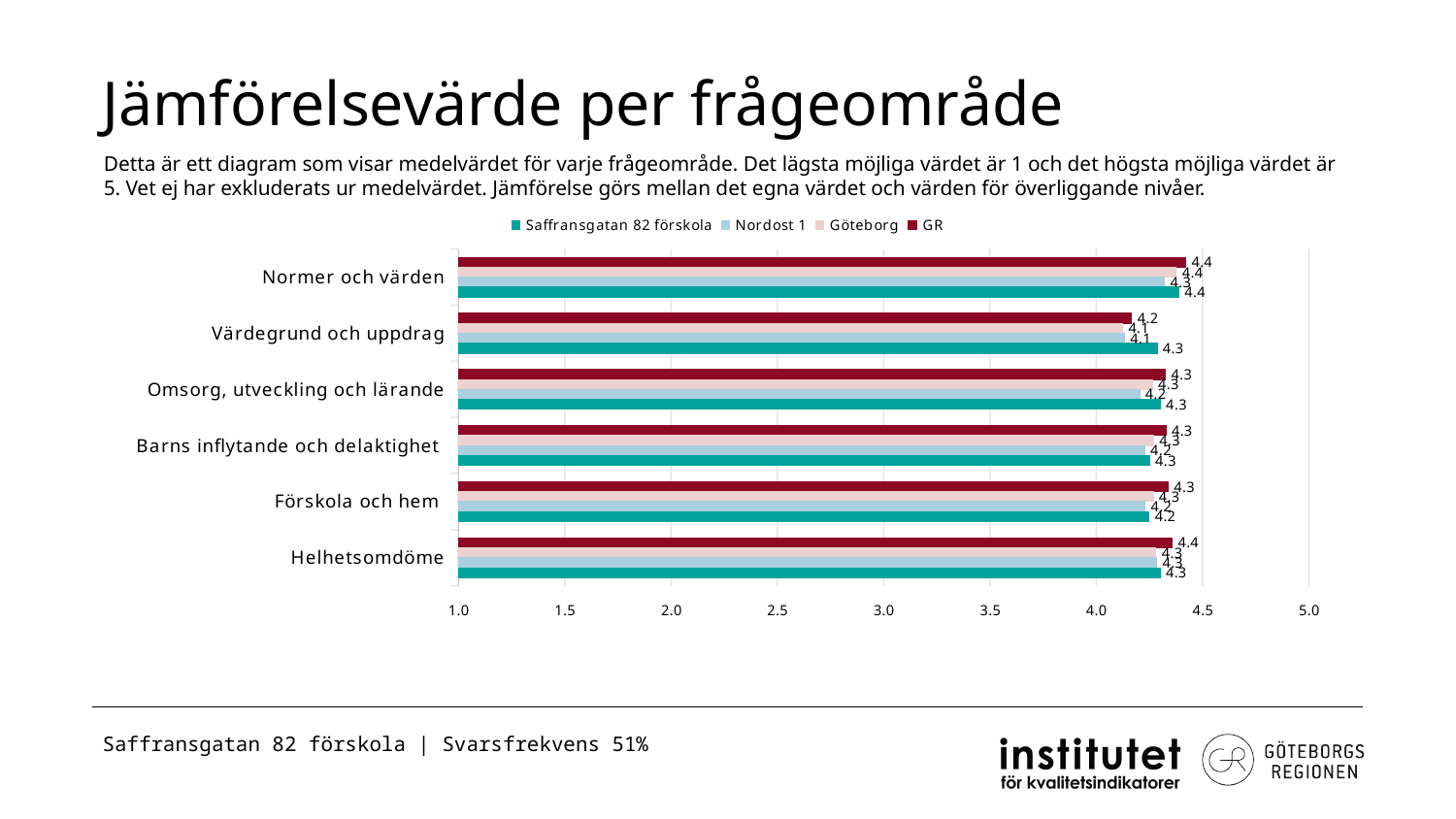
In which question area does Saffransgatan 82 förskola have its highest value? Normer och värden How many series does the legend list? 4 Which colour represents GR in the legend? dark red What is the value for GR in 'Helhetsomdöme'? 4,4 What is the value for Nordost 1 in 'Normer och värden'? 4,3 What is the difference between the Saffransgatan 82 förskola value and the GR value in 'Värdegrund och uppdrag'? 0,1 What is the value for Göteborg in 'Förskola och hem'? 4,3 In which question area does Saffransgatan 82 förskola have its lowest value? Förskola och hem What is the value for Saffransgatan 82 förskola in 'Värdegrund och uppdrag'? 4,3 How many question areas (categories) are shown on the y axis? 6 What type of chart is shown on the slide? bar chart In 'Värdegrund och uppdrag', which is larger: the value for Saffransgatan 82 förskola or the value for Göteborg? Saffransgatan 82 förskola